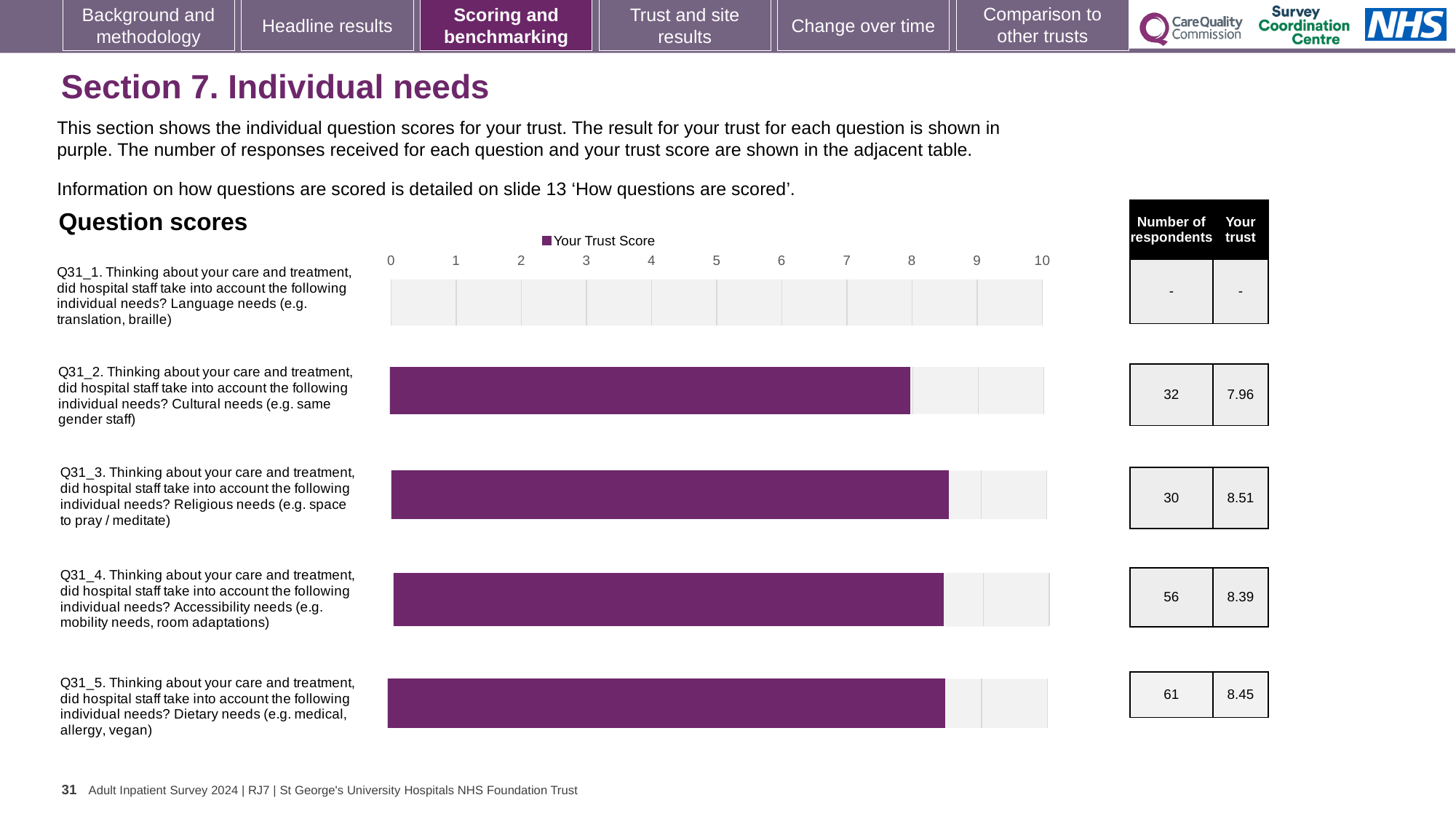
What series does the chart legend list? Your Trust Score Is the value for Q31_3 greater or less than 8? greater What is the trust score for Q31_2 (cultural needs)? 7.96 What is the trust score for Q31_5 (dietary needs)? 8.45 How many questions are listed on the chart? 5 Which question has the highest trust score shown on the chart? Q31_3 How many respondents answered Q31_4 (accessibility needs)? 56 Which has the larger trust score, Q31_4 or Q31_2? Q31_4 What kind of chart is shown on the slide? Bar chart Which question has the lowest trust score shown on the chart? Q31_2 What is the difference between the trust scores for Q31_3 and Q31_2? 0.55 What is the trust score for Q31_3 (religious needs)? 8.51